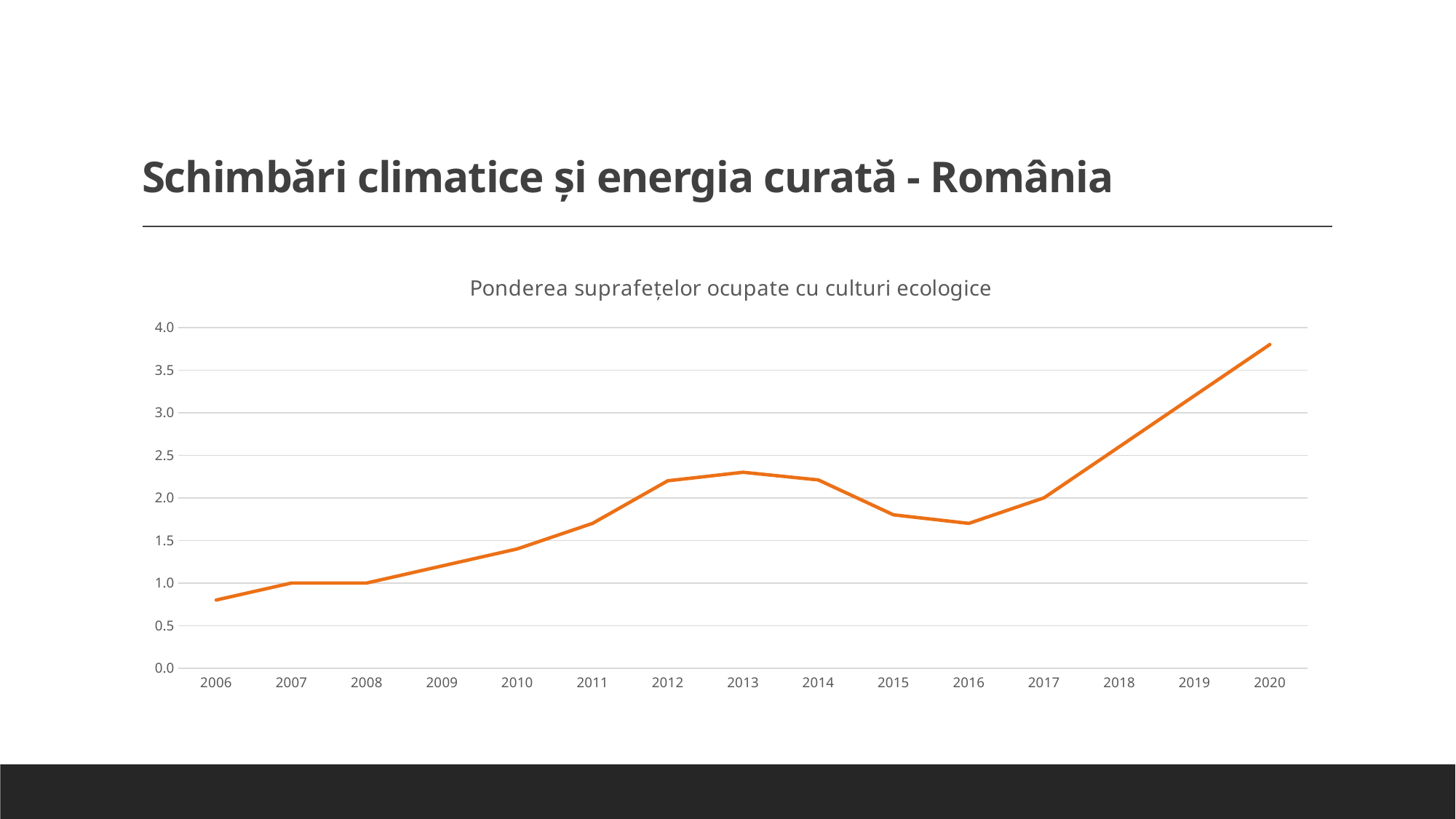
How many years are plotted on the x axis? 15 Do the values generally rise or fall from 2006 to 2020? rise What is the value for 2007? 1.0 Which year has the lowest value? 2006 What is the title of the chart? Ponderea suprafețelor ocupate cu culturi ecologice Is the value for 2006 greater or less than 1.0? less Which is larger, the value for 2013 or the value for 2016? 2013 Is the value for 2020 greater or less than 3.5? greater What kind of chart is shown on the slide? line chart Is the value for 2013 greater or less than 2.0? greater What is the value for 2017? 2.0 Which year has the highest value? 2020